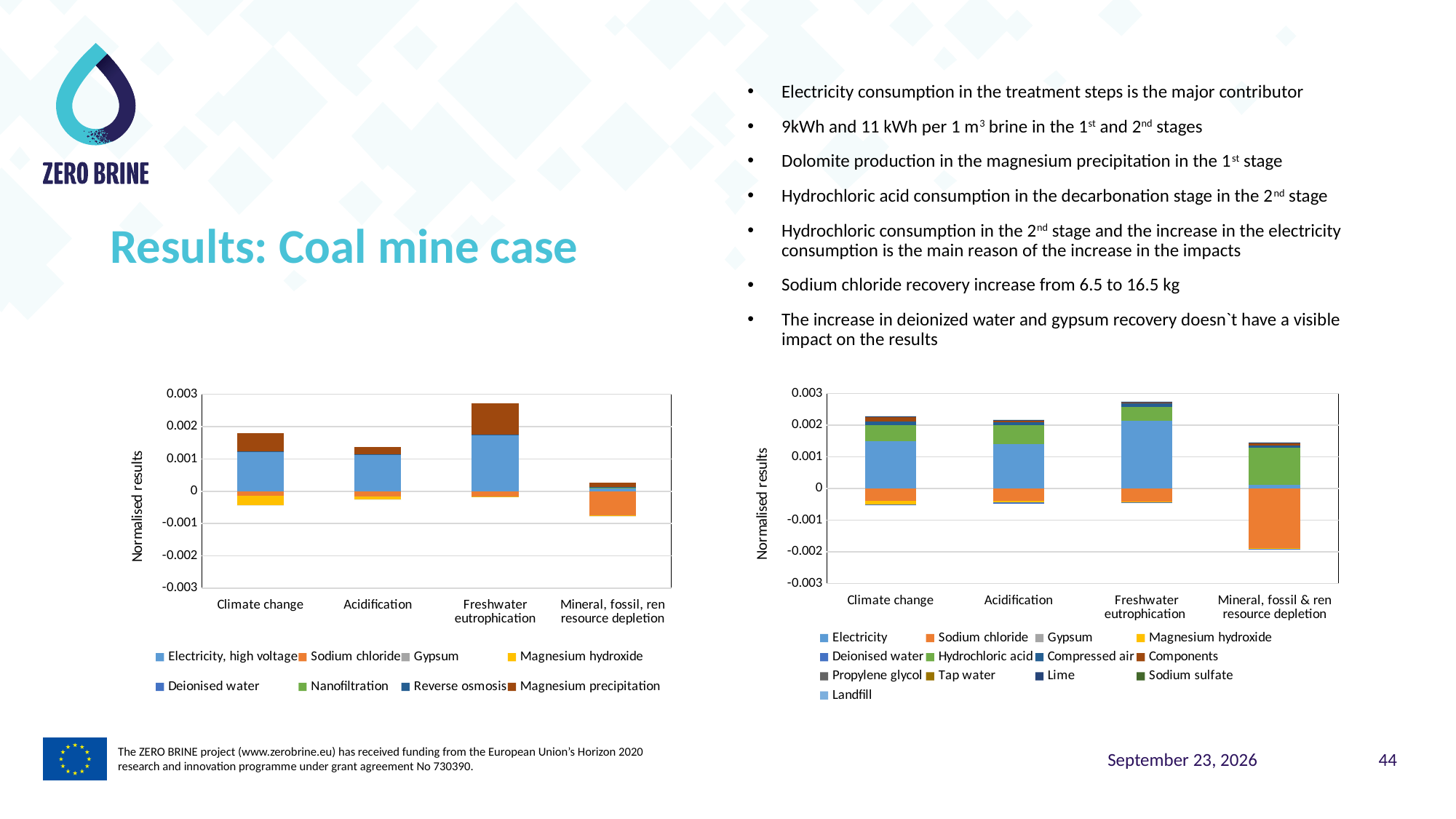
In the right chart, which category has the tallest positive stacked bar? Freshwater eutrophication How many series does the legend of the left chart list? 8 In the right chart, is the bottom of the negative stack for Mineral, fossil & ren resource depletion greater or less than -0.001? less In the left chart, which category has the smallest positive stacked bar? Mineral, fossil, ren resource depletion How many series does the legend of the right chart list? 13 In the right chart, which series is shown in orange according to the legend? Sodium chloride What type of chart is the left chart on the slide? Stacked bar chart In the left chart, is the top of the positive stack for Freshwater eutrophication greater or less than 0.002? greater In the left chart, is the top of the positive stack for Climate change greater or less than 0.002? less How many categories are shown on the x axis of the left chart? 4 In the left chart, which category has the tallest positive stacked bar? Freshwater eutrophication What is the y-axis title of the right chart? Normalised results